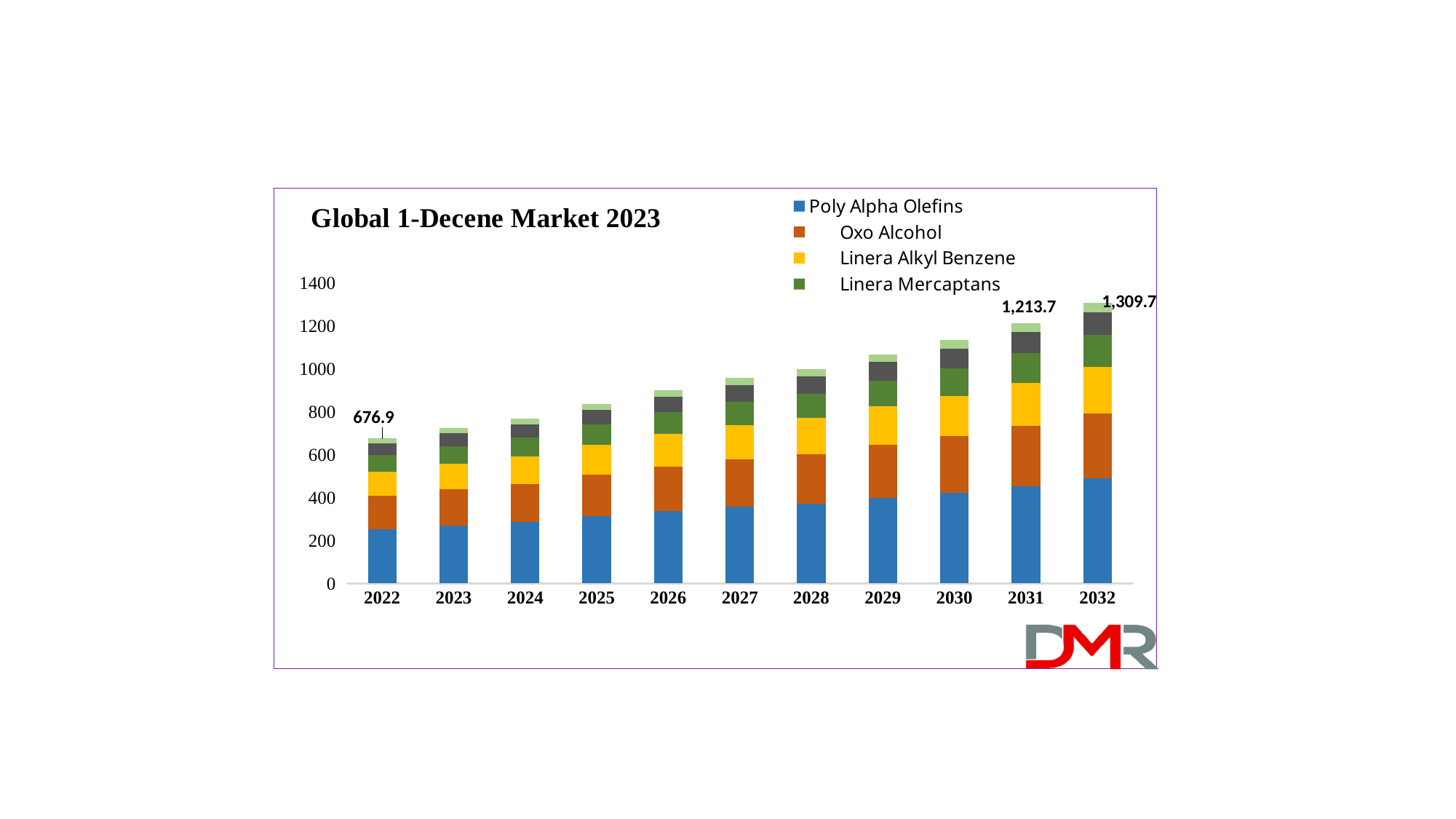
Which year has the lowest total bar? 2022 What is the total value labelled for 2031? 1,213.7 What is the total value labelled for 2022? 676.9 What is the difference between the labelled totals for 2032 and 2031? 96.0 What kind of chart is shown on the slide? Stacked bar chart How many years are shown along the x axis? 11 What is the total value labelled for 2032? 1,309.7 Is the total for 2027 greater or less than 1000? less What is the title of the chart? Global 1-Decene Market 2023 Which year has the highest total bar? 2032 Do the total bar values rise or fall from 2022 to 2032? Rise How many series does the legend list? 4